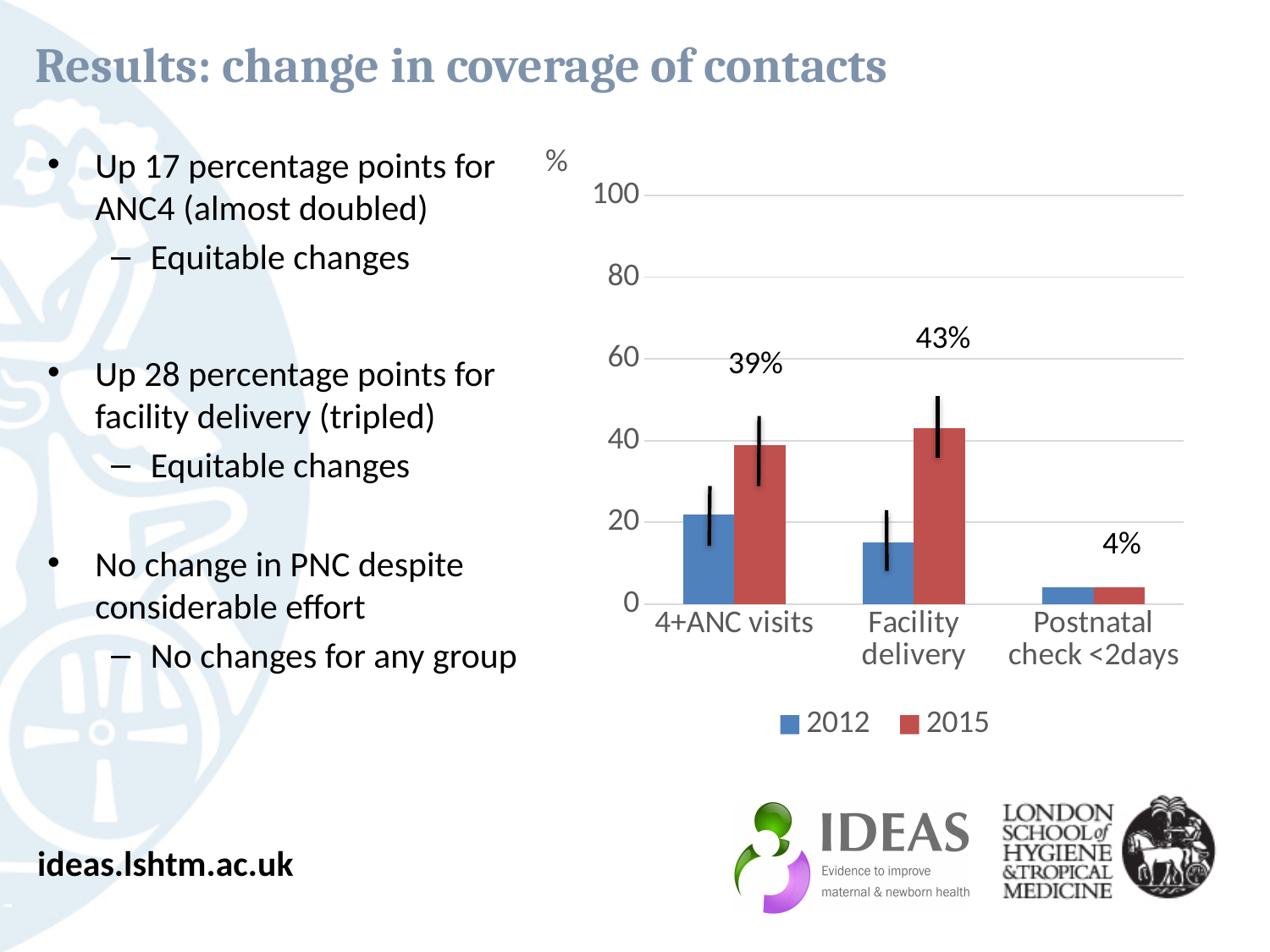
Which category has the lowest 2015 value? Postnatal check <2days Which category has the highest 2015 value? Facility delivery What kind of chart is shown on the slide? Bar chart For 4+ANC visits, which series has the larger value, 2012 or 2015? 2015 What is the 2015 value for Facility delivery? 43% How many series does the legend list? 2 What is the 2015 value for Postnatal check <2days? 4% Is the 2012 value for Facility delivery greater or less than 20? less How many categories are shown on the x axis? 3 Is the 2012 value for 4+ANC visits greater or less than 40? less What is the difference between the 2015 values for Facility delivery and 4+ANC visits? 4 percentage points What is the 2015 value for 4+ANC visits? 39%